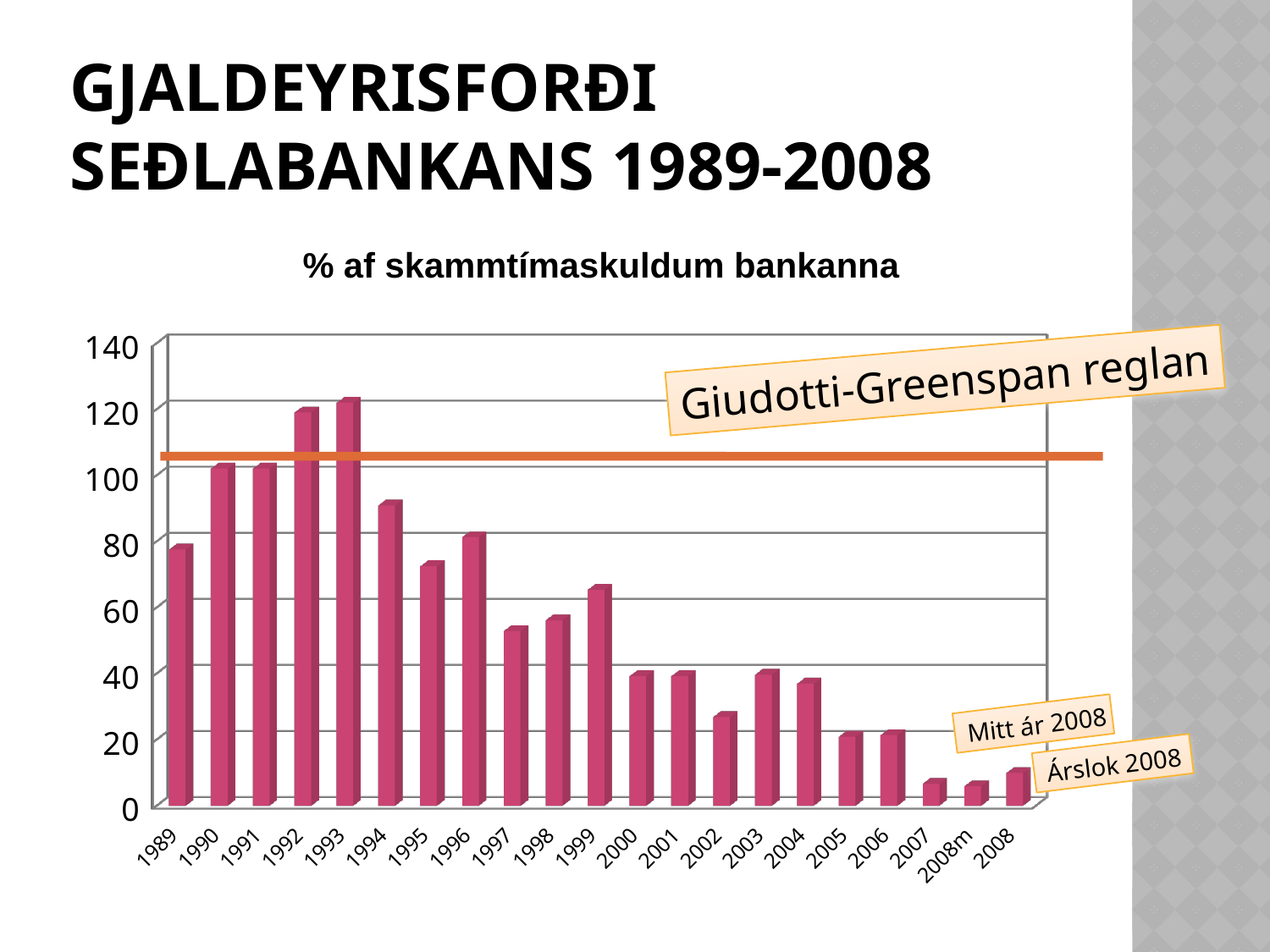
How many bars (categories) are plotted on the chart? 21 Which is larger, the value for 2002 or the value for 2003? 2003 Is the value for 2002 greater or less than 40? less What kind of chart is shown on the slide? bar chart What is the label on the orange horizontal line across the chart? Giudotti-Greenspan reglan Which is larger, the value for 1989 or the value for 1990? 1990 Which year has the highest bar on the chart? 1993 Is the value for 2007 greater or less than 20? less Is the value for 1997 greater or less than 60? less Do the values generally rise or fall from 1993 to 2008? fall